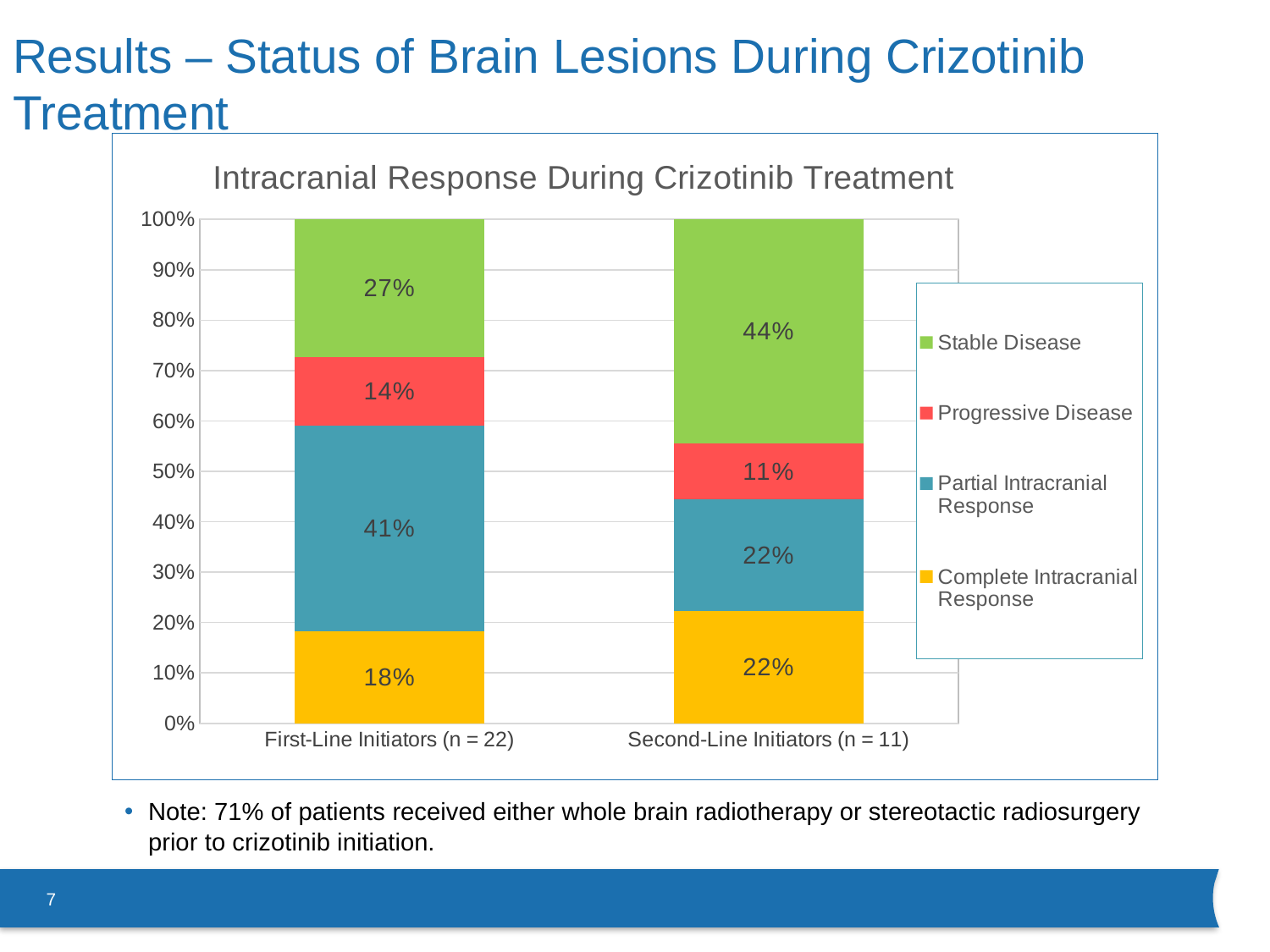
What is the Progressive Disease value for Second-Line Initiators (n = 11)? 11% What is the Stable Disease value for Second-Line Initiators (n = 11)? 44% What kind of chart is shown on the slide? Stacked bar chart What is the title of the chart? Intracranial Response During Crizotinib Treatment Which response category has the smallest share among Second-Line Initiators (n = 11)? Progressive Disease Which group has the larger Partial Intracranial Response share, First-Line Initiators or Second-Line Initiators? First-Line Initiators (n = 22) What is the Partial Intracranial Response value for First-Line Initiators (n = 22)? 41% How many patient groups are shown on the x axis? 2 What is the Complete Intracranial Response value for First-Line Initiators (n = 22)? 18% What is the difference between the Stable Disease values for Second-Line Initiators and First-Line Initiators? 17% How many series does the legend list? 4 Which response category has the largest share among First-Line Initiators (n = 22)? Partial Intracranial Response